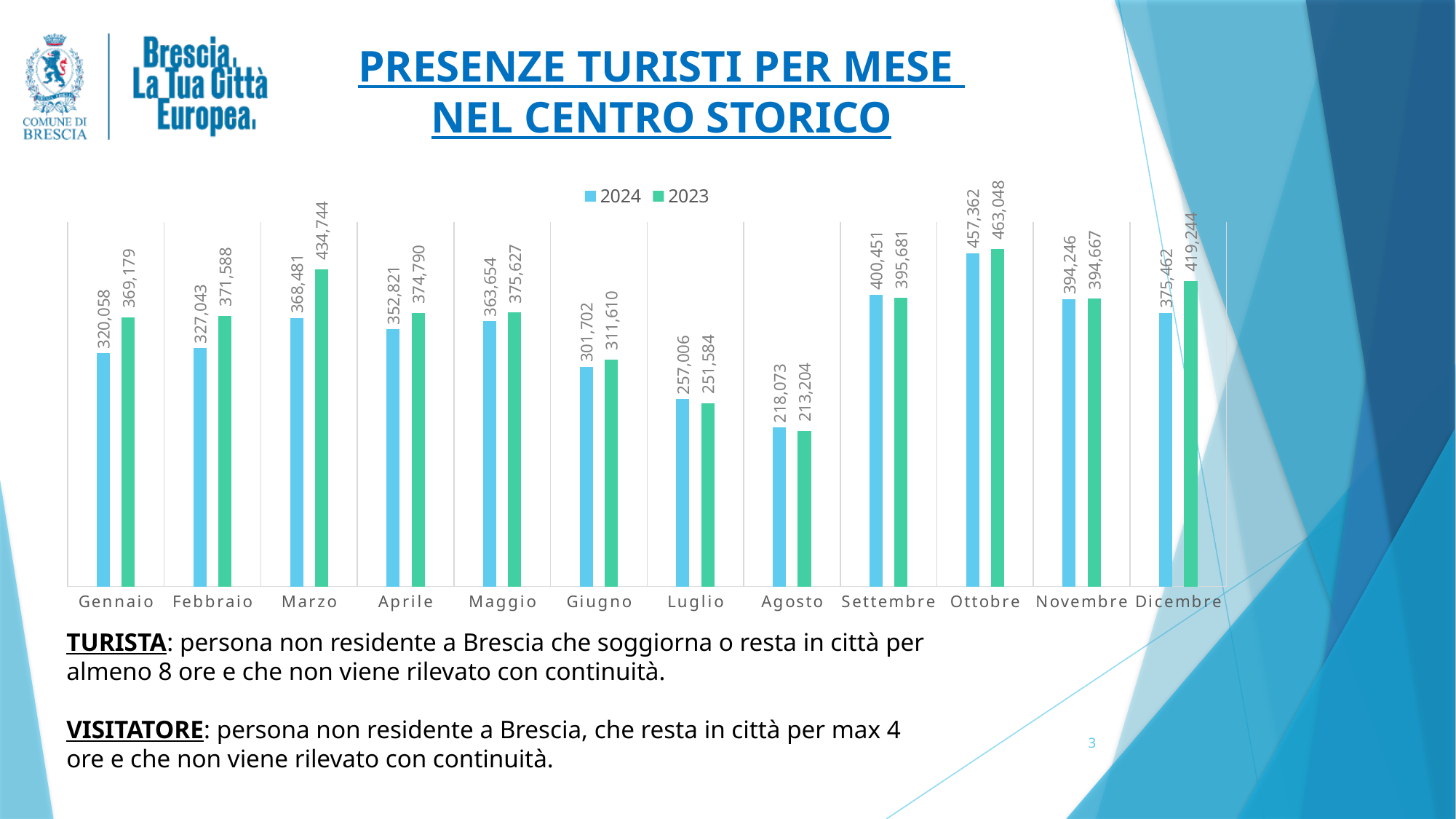
How many months are shown on the x axis? 12 What is the difference between the 2023 and 2024 values for Marzo? 66,263 What is the value for Agosto in the 2023 series? 213,204 What is the value for Gennaio in the 2024 series? 320,058 For Luglio, which series has the larger value, 2024 or 2023? 2024 For Dicembre, which series has the larger value, 2024 or 2023? 2023 Which month has the lowest value in the 2023 series? Agosto Which month has the highest value in the 2024 series? Ottobre What kind of chart is shown on the slide? Bar chart How many series does the legend list? 2 What is the value for Marzo in the 2023 series? 434,744 What is the difference between the 2023 and 2024 values for Gennaio? 49,121